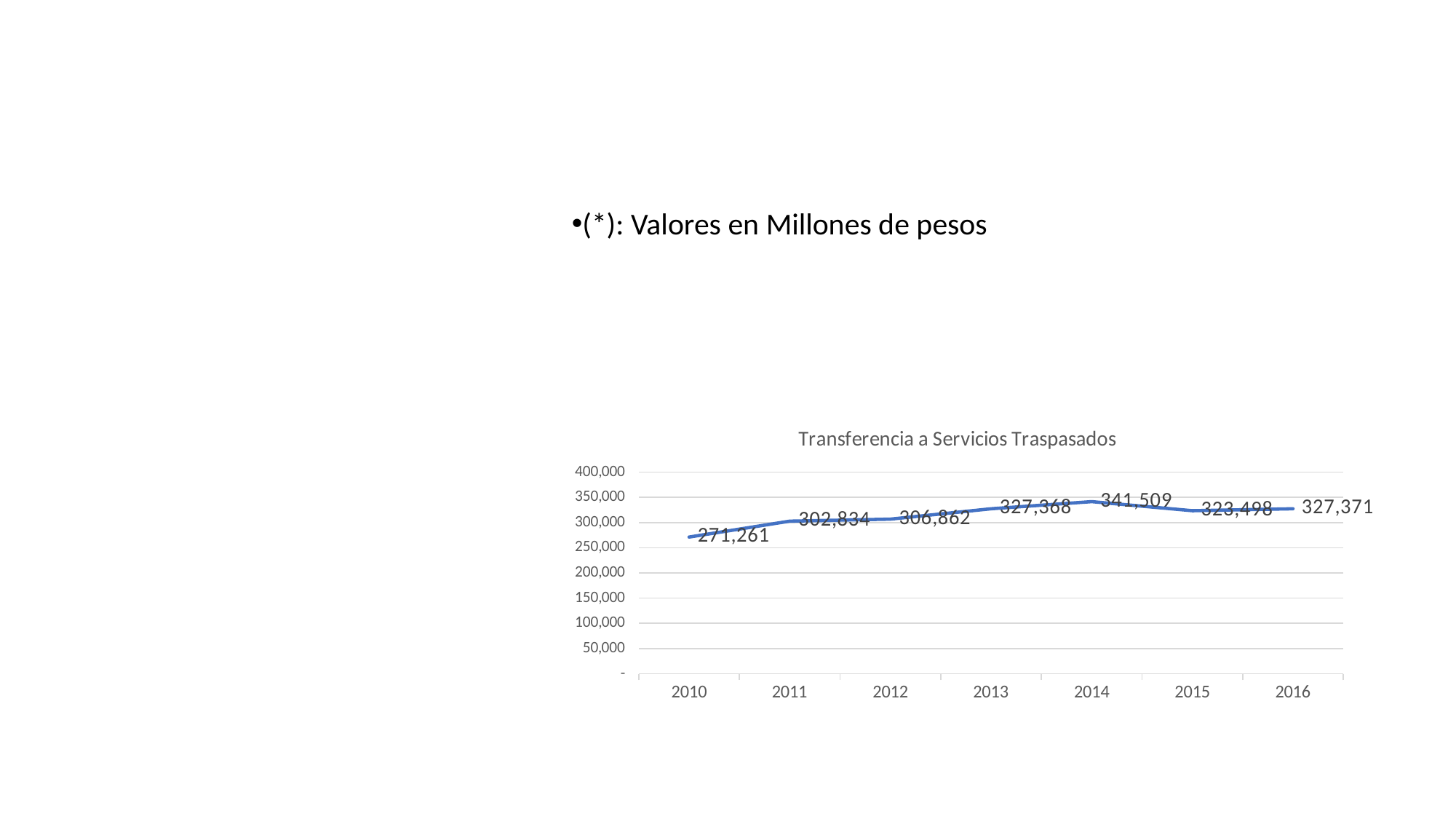
Is the value for 2012 greater or less than 350,000? less What kind of chart is shown on the slide? line chart Which year has the lowest value in the Transferencia a Servicios Traspasados chart? 2010 What is the difference between the 2016 and 2015 values in the Transferencia a Servicios Traspasados chart? 3,873 Which year has the larger value, 2014 or 2015? 2014 What is the difference between the 2014 and 2010 values in the Transferencia a Servicios Traspasados chart? 70,248 Which year has the highest value in the Transferencia a Servicios Traspasados chart? 2014 Do the values rise or fall from 2010 to 2014 in the Transferencia a Servicios Traspasados chart? rise What is the value for 2016 in the Transferencia a Servicios Traspasados chart? 327,371 How many years are plotted in the Transferencia a Servicios Traspasados chart? 7 What is the value for 2014 in the Transferencia a Servicios Traspasados chart? 341,509 What is the value for 2010 in the Transferencia a Servicios Traspasados chart? 271,261